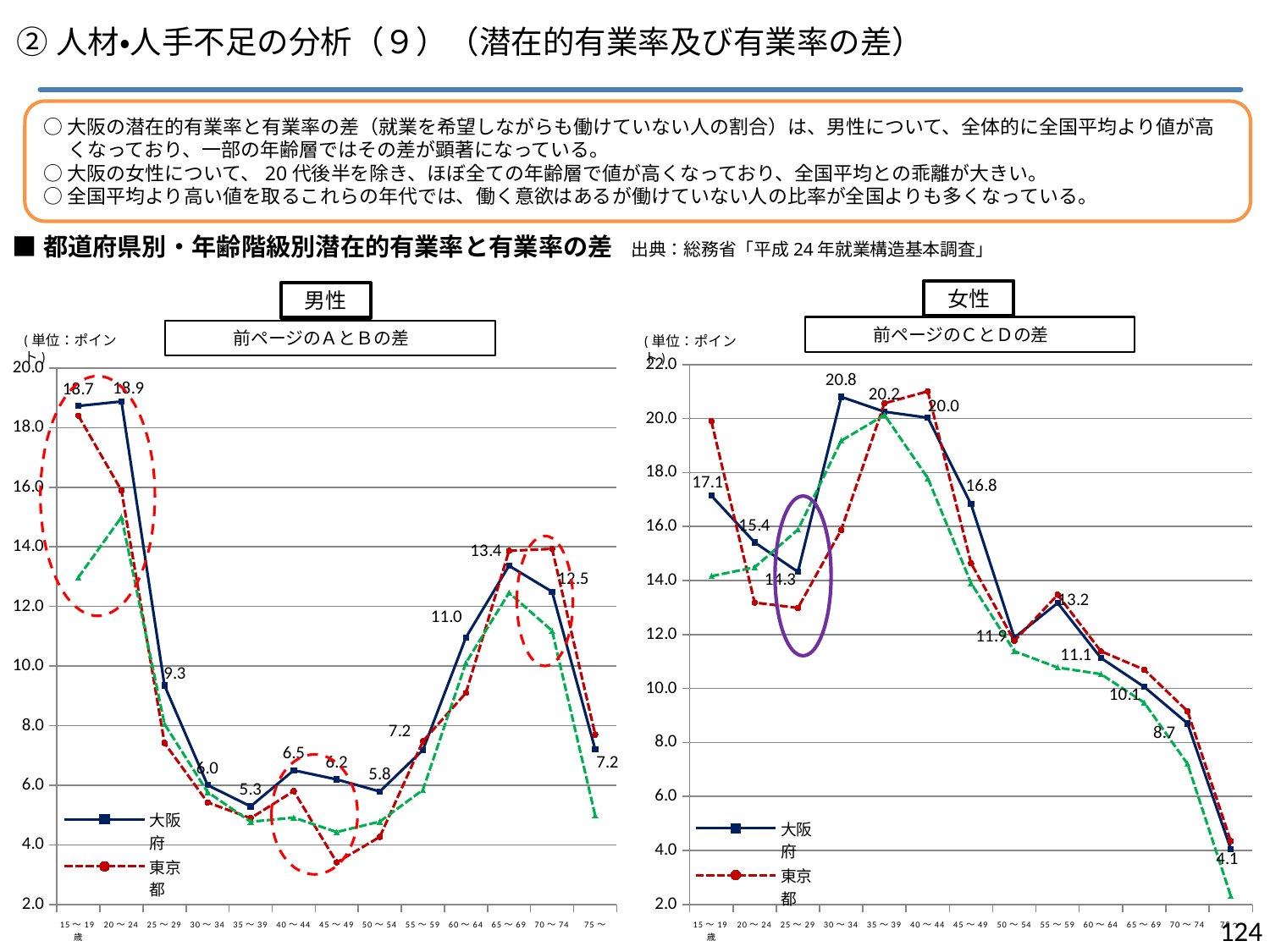
How many age groups are plotted along the x axis of the 女性 chart? 13 In the 女性 chart, what is the 大阪府 value for the 30～34 age group? 20.8 In the 男性 chart, which age group has the lowest 大阪府 value? 35～39 What type of chart is the 男性 chart? Line chart In the 男性 chart, is the 東京都 value for 25～29 greater or less than 8.0? less In the 女性 chart, does the 大阪府 line rise or fall from 55～59 to 75～? Falls In the 男性 chart, which age group has the highest 大阪府 value? 20～24 In the 女性 chart, which age group has the lowest 大阪府 value? 75～ In the 女性 chart, what is the difference between the 大阪府 values for 30～34 and 25～29? 6.5 In the 男性 chart, which is larger for 大阪府: the value for 65～69 or for 70～74? 65～69 In the 女性 chart, which age group has the highest 大阪府 value? 30～34 In the 男性 chart, what is the 大阪府 value for the 20～24 age group? 18.9